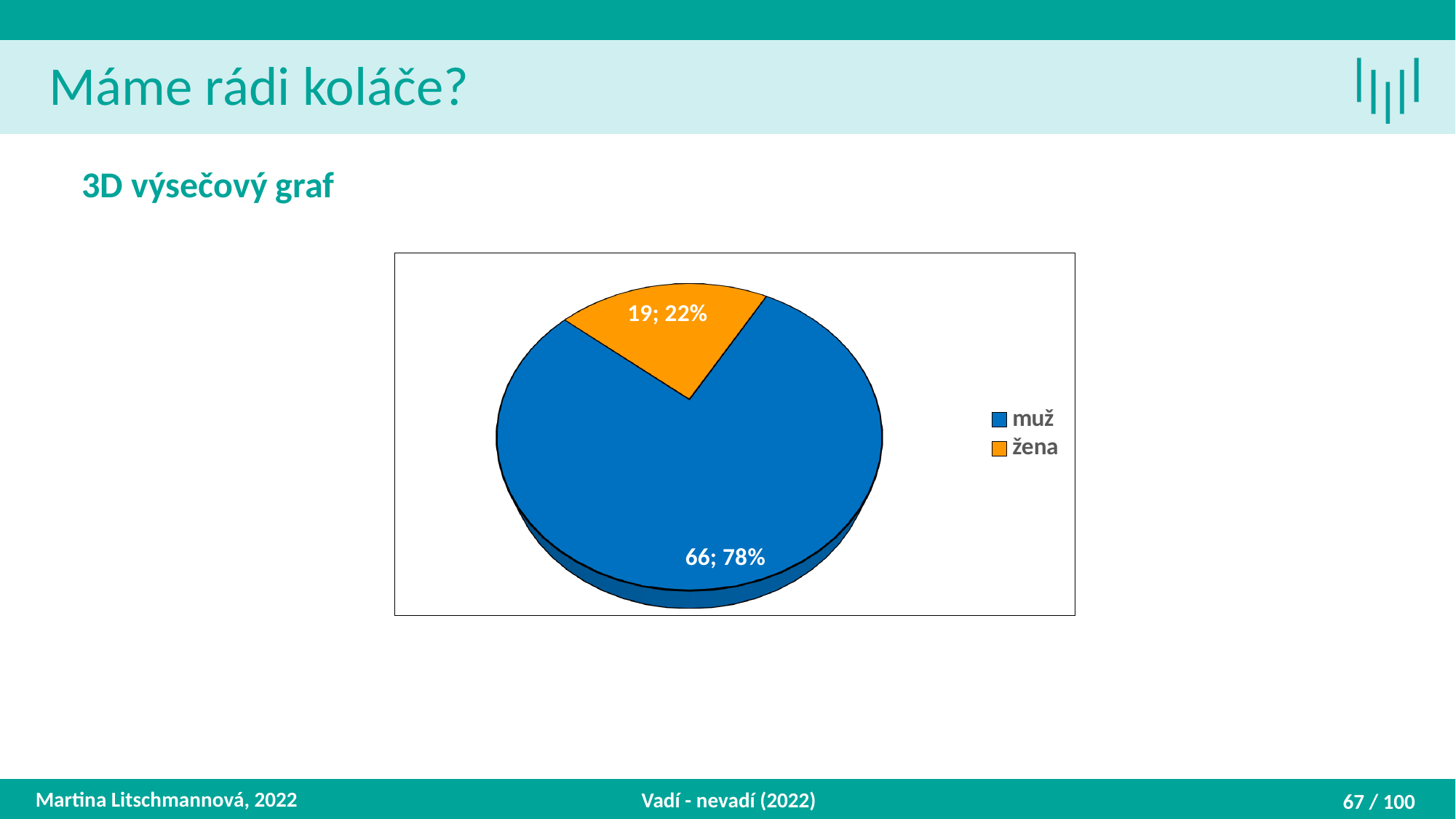
What kind of chart is shown on the slide? pie chart Which slice is larger, muž or žena? muž What is the count shown for the žena slice? 19 What percentage share does the žena slice have? 22% What is the difference between the counts for muž and žena? 47 Which category has the smallest slice? žena How many slices does the pie chart have? 2 What percentage share does the muž slice have? 78% How many entries does the legend list? 2 What colour is the žena slice? orange What is the count shown for the muž slice? 66 Which category has the largest slice? muž